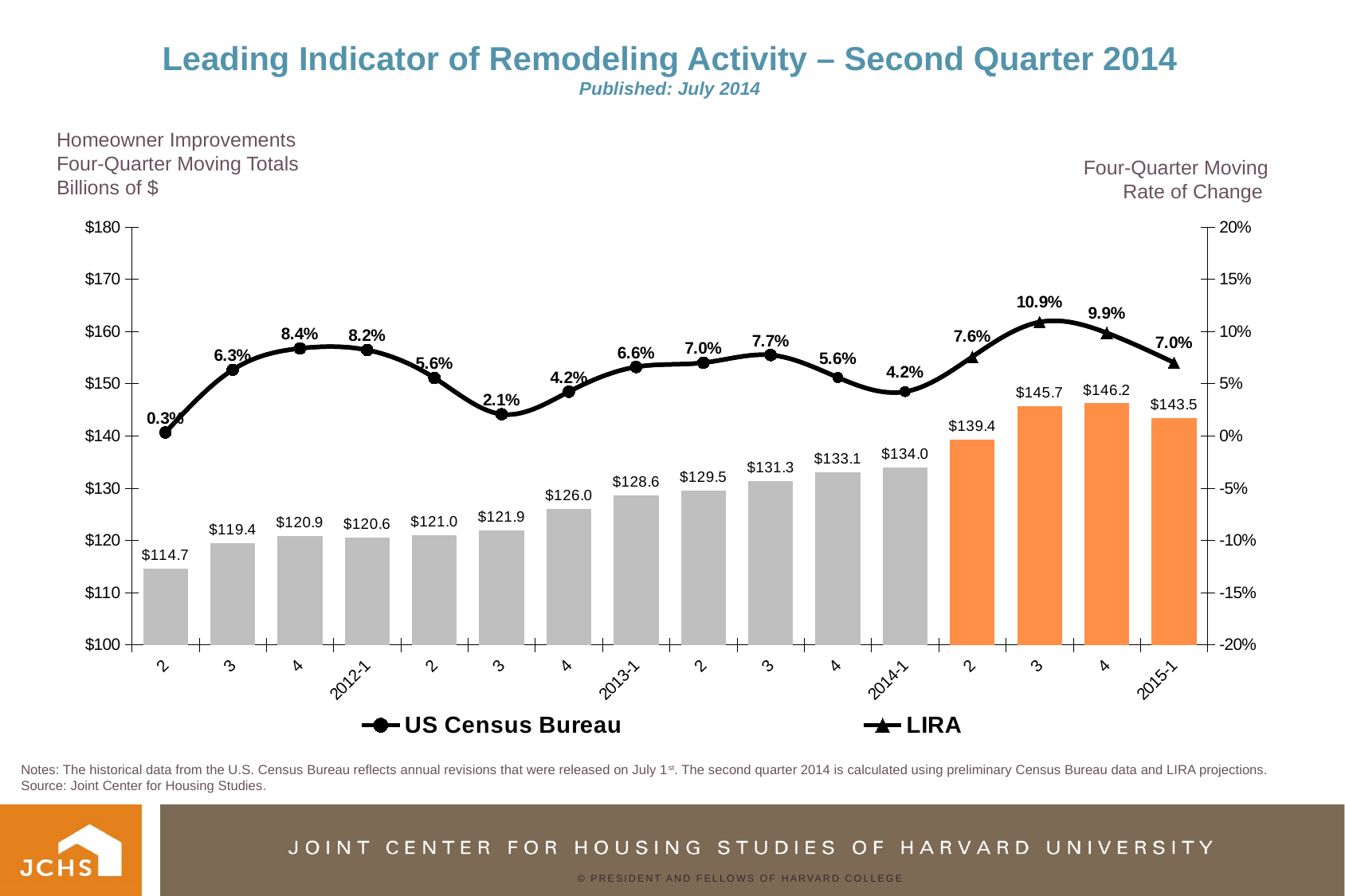
What is the four-quarter moving total shown for 2012-1? $120.6 What is the highest four-quarter moving rate of change shown on the line? 10.9% How many quarters are shown along the x axis? 16 What is the lowest four-quarter moving rate of change shown on the line? 0.3% What is the four-quarter moving rate of change shown for 2014-1? 4.2% How many series does the legend list? 2 What is the highest four-quarter moving total shown on the bars? $146.2 What is the difference between the four-quarter moving totals for 2013-1 and 2012-1? $8.0 Which has the larger four-quarter moving total, 2014-1 or 2015-1? 2015-1 What is the lowest four-quarter moving total shown on the bars? $114.7 What is the four-quarter moving total shown for 2015-1? $143.5 Is the four-quarter moving total for 2014-1 greater or less than $130? greater